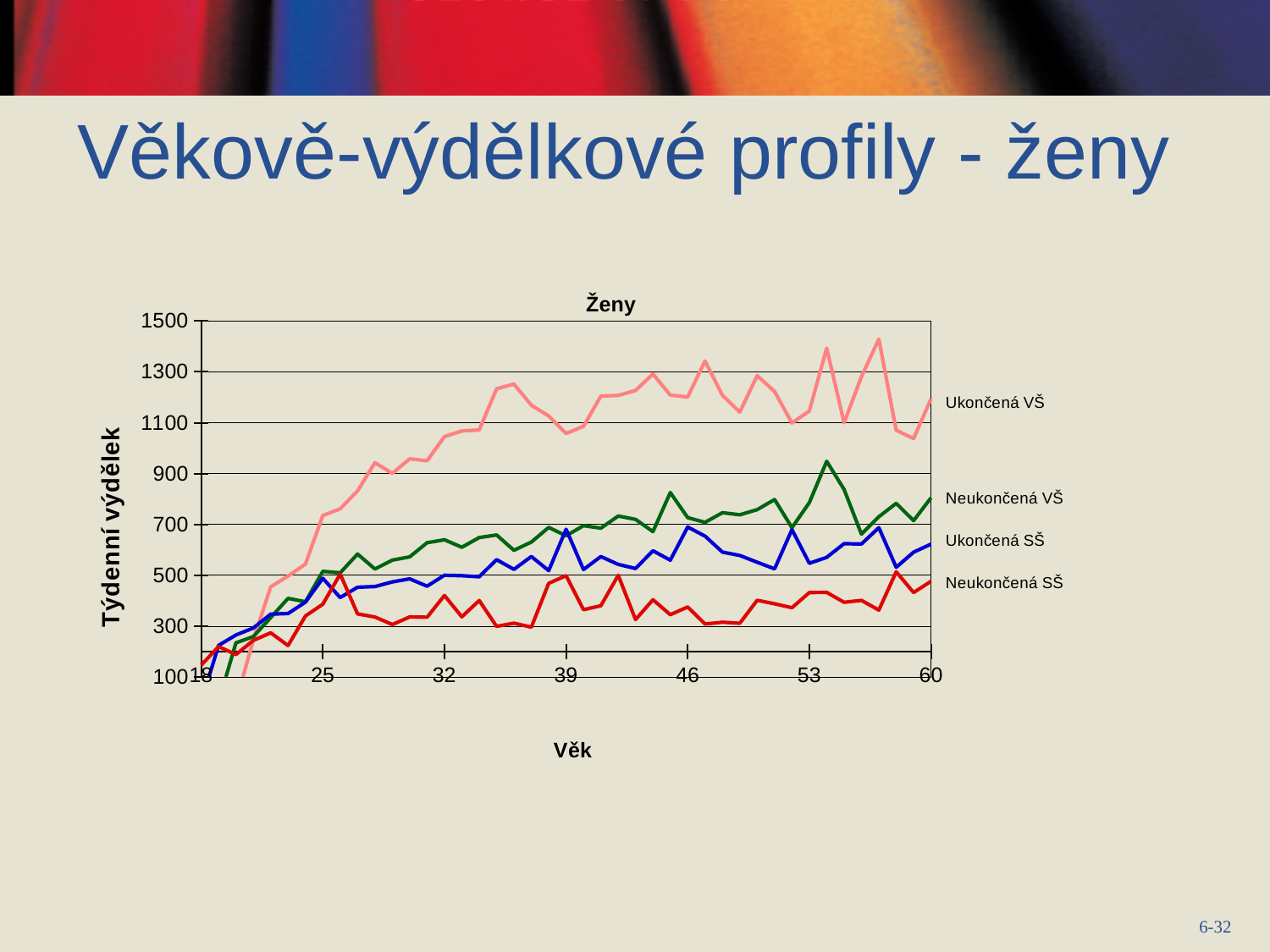
What kind of chart is shown on the slide? line chart Is the value for Neukončená SŠ at age 46 greater or less than 500? less What is the title of the chart? Ženy What is the highest value shown on the vertical axis? 1500 Is the value for Ukončená VŠ at age 46 greater or less than 1100? greater Does the Ukončená VŠ series rise or fall between age 18 and age 39? rise What is the label of the vertical axis? Týdenní výdělek Is the value for Ukončená SŠ at age 32 greater or less than 700? less At age 53, which is larger: Neukončená VŠ or Ukončená SŠ? Neukončená VŠ How many series are labelled on the chart? 4 Which series has the highest values at age 46? Ukončená VŠ Which series has the lowest values at age 46? Neukončená SŠ